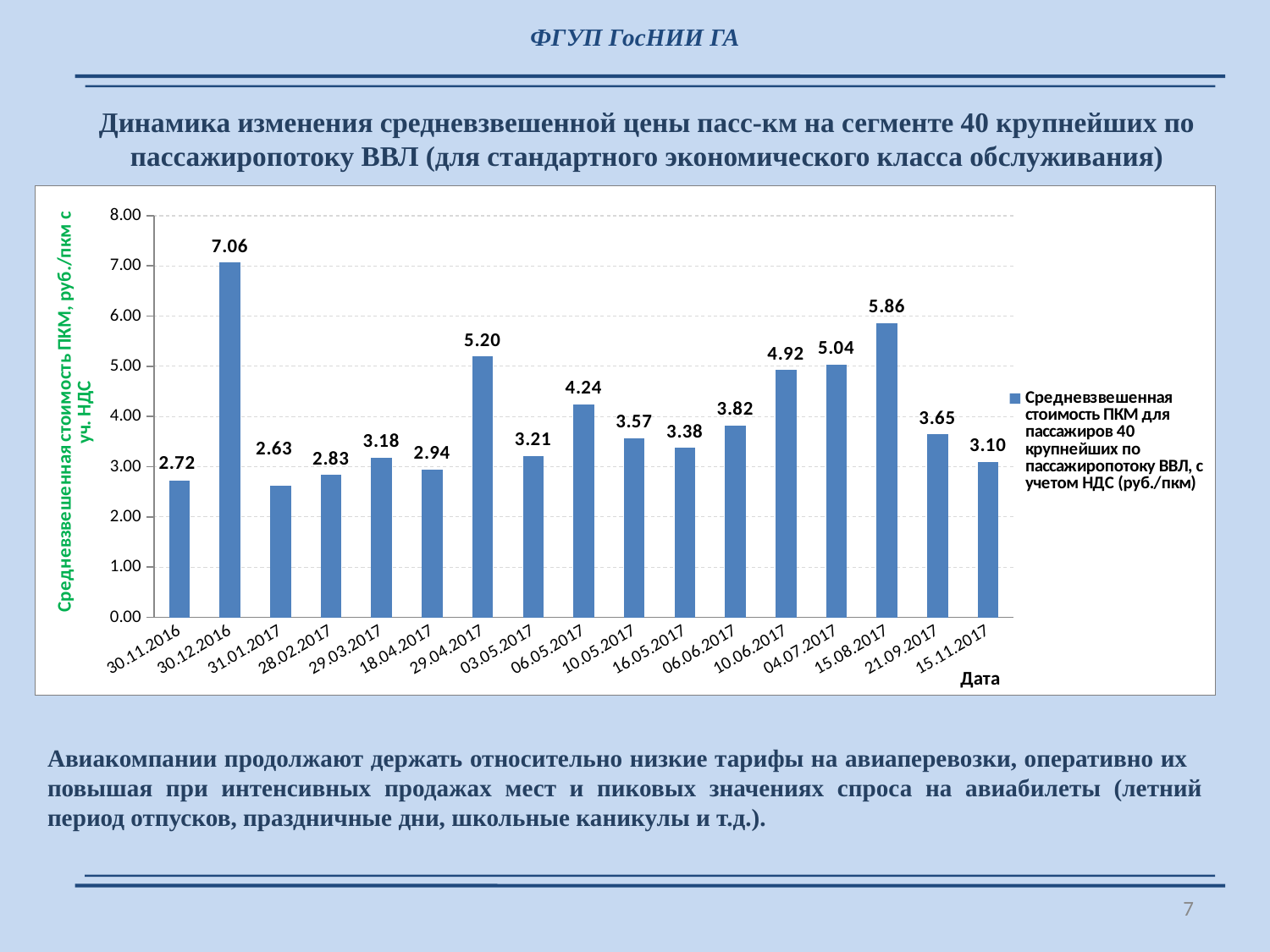
How many dates are shown on the x axis? 17 What is the difference between the values for 30.12.2016 and 31.01.2017? 4.43 How many series does the legend list? 1 Which is larger, the value for 10.06.2017 or the value for 04.07.2017? 04.07.2017 Is the value for 06.05.2017 greater or less than 4.00? greater What is the value for 29.04.2017? 5.20 What is the value for 15.11.2017? 3.10 Which date has the lowest value? 31.01.2017 What is the value for 15.08.2017? 5.86 Which date has the highest value? 30.12.2016 What kind of chart is shown on the slide? bar chart What is the value for 30.12.2016? 7.06